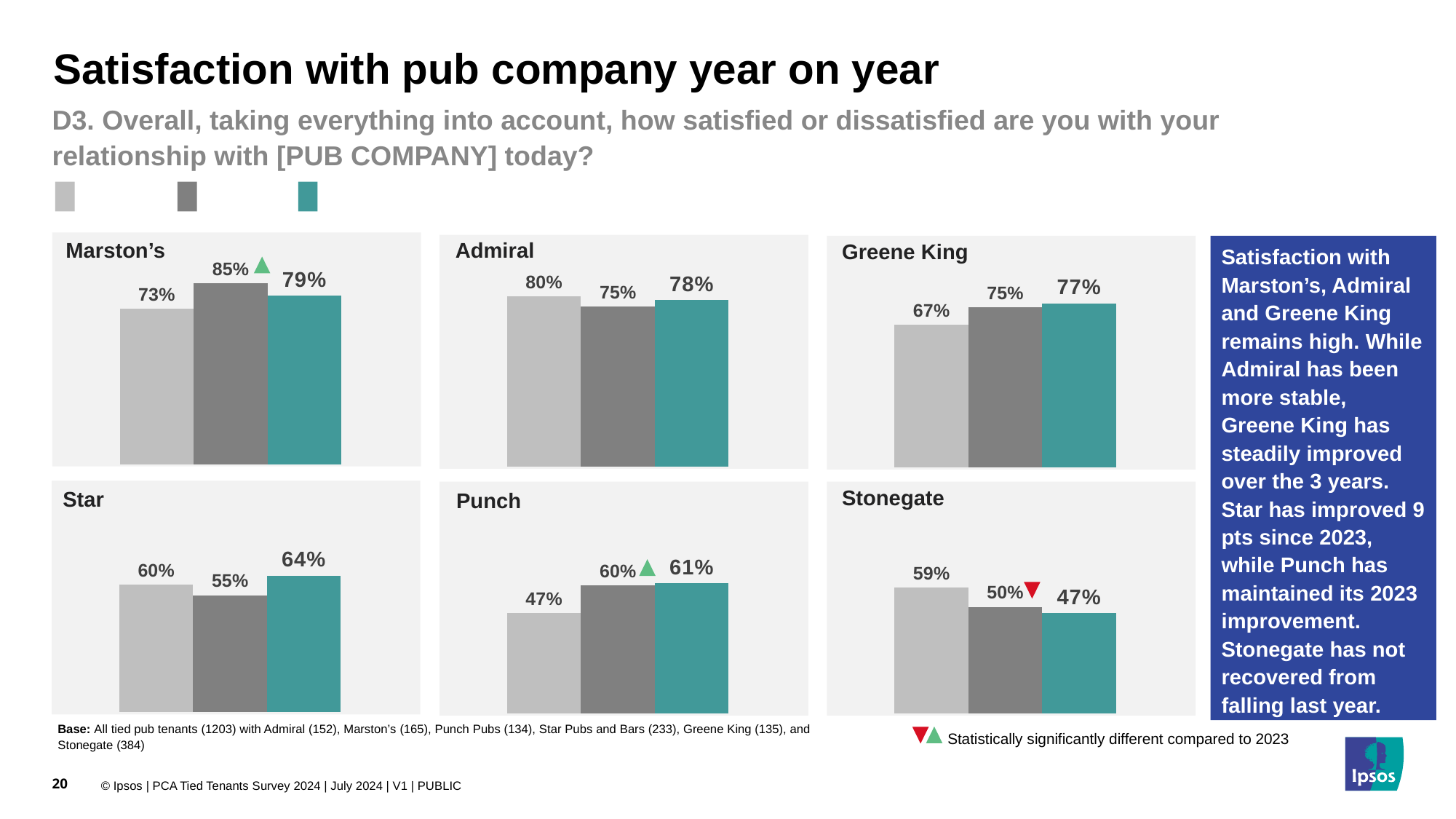
Which is larger: the teal bar for Greene King or the teal bar for Admiral? Admiral (78%) What type of chart is used for each pub company on this slide? Bar chart In the Admiral chart, what is the value of the light grey (first) bar? 80% In the Punch chart, which bar has the lowest value? The light grey (first) bar, 47% In the Stonegate chart, what is the value of the teal (third) bar? 47% In the Marston's chart, what is the value of the teal (third) bar? 79% In the Greene King chart, what is the value of the dark grey (second) bar? 75% In the Star chart, what is the difference between the teal (third) bar and the dark grey (second) bar? 9 percentage points In the Greene King chart, do the values rise or fall from the first bar to the third bar? Rise How many bars are shown in the Punch chart? 3 In the Marston's chart, which bar has the highest value? The dark grey (second) bar, 85% In the Stonegate chart, what is the difference between the light grey (first) bar and the teal (third) bar? 12 percentage points